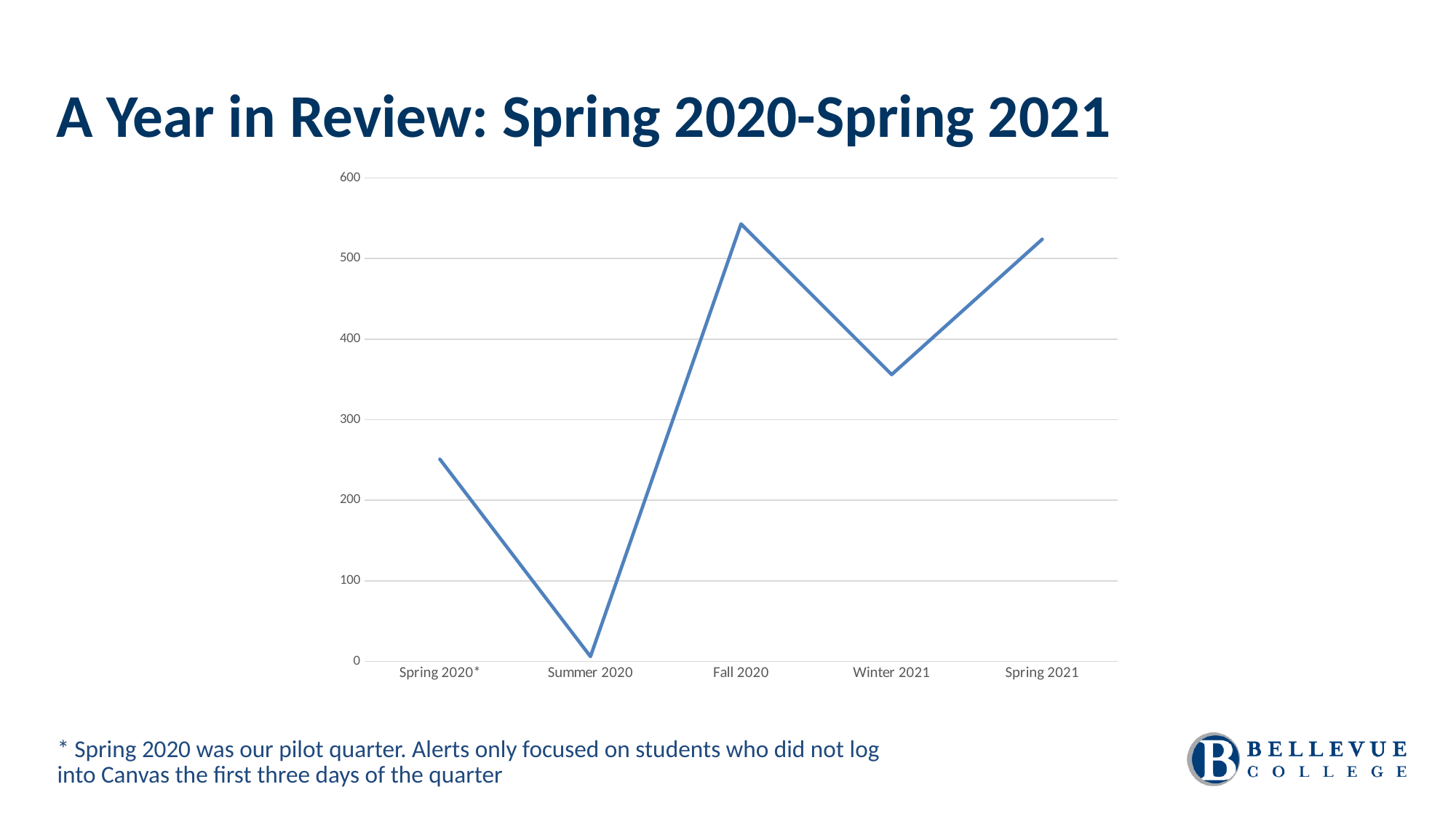
Does the line rise or fall from Fall 2020 to Winter 2021? fall Which quarter has the lowest value on the chart? Summer 2020 Is the value for Spring 2020* greater or less than 200? greater Is the value for Fall 2020 greater or less than 500? greater Which is larger, the value for Spring 2020* or the value for Winter 2021? Winter 2021 Is the value for Winter 2021 greater or less than 400? less What is the title of the slide containing the chart? A Year in Review: Spring 2020-Spring 2021 What kind of chart is shown on the slide? line chart How many data points are plotted on the line chart? 5 Does the line rise or fall from Summer 2020 to Fall 2020? rise